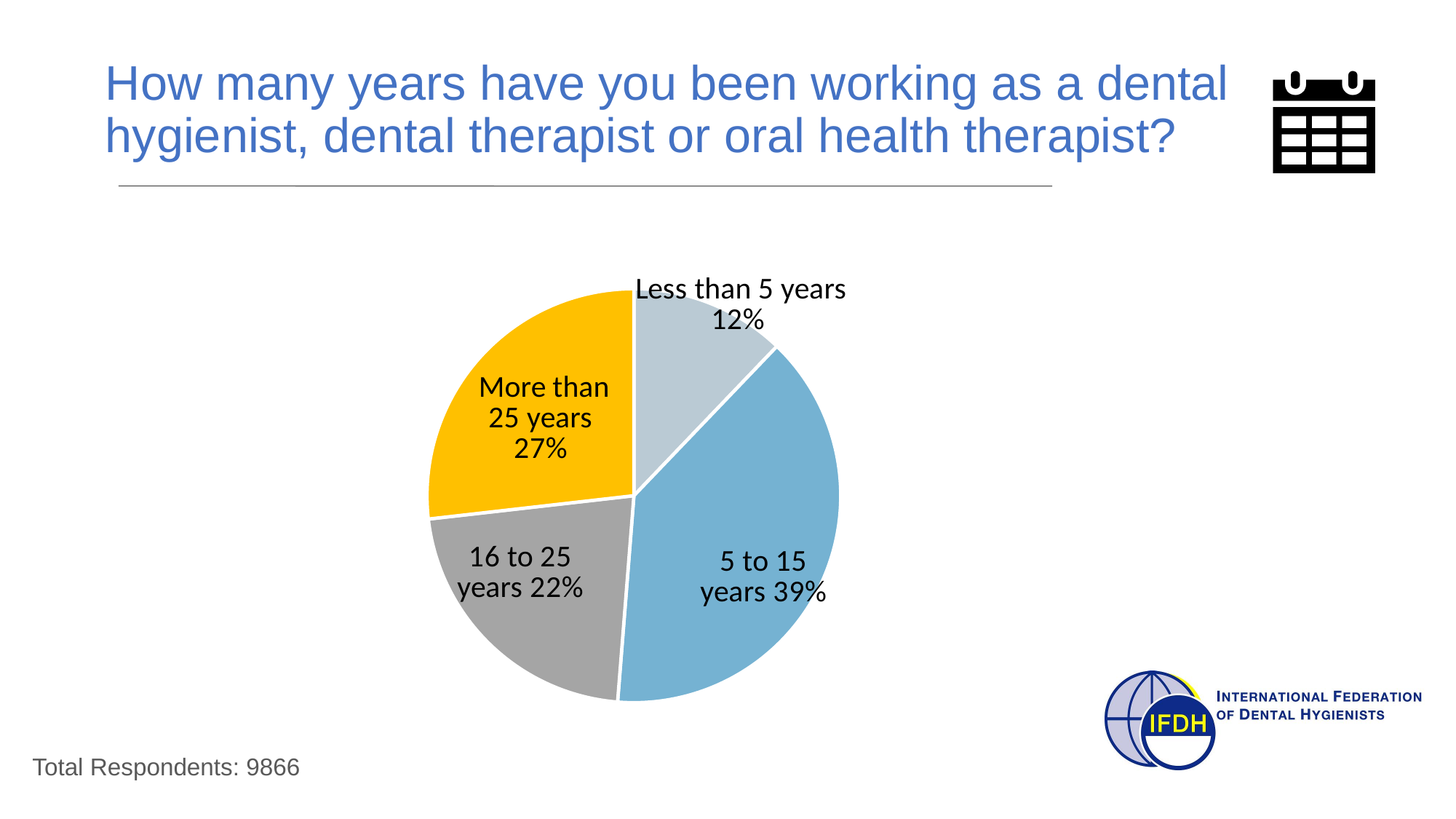
Which category has the smallest share of the pie? Less than 5 years What kind of chart is shown on the slide? Pie chart What is the difference in percentage points between the 5 to 15 years slice and the 16 to 25 years slice? 17 What percentage of respondents have been working for 5 to 15 years? 39% What is the total number of respondents stated on the slide? 9866 What percentage of respondents have been working for 16 to 25 years? 22% How many categories are shown in the pie chart? 4 Which category has the largest share of the pie? 5 to 15 years What colour is the slice for more than 25 years? Yellow What percentage of respondents have been working for more than 25 years? 27% Which is larger: the share for more than 25 years or the share for 16 to 25 years? More than 25 years What percentage of respondents have been working for less than 5 years? 12%